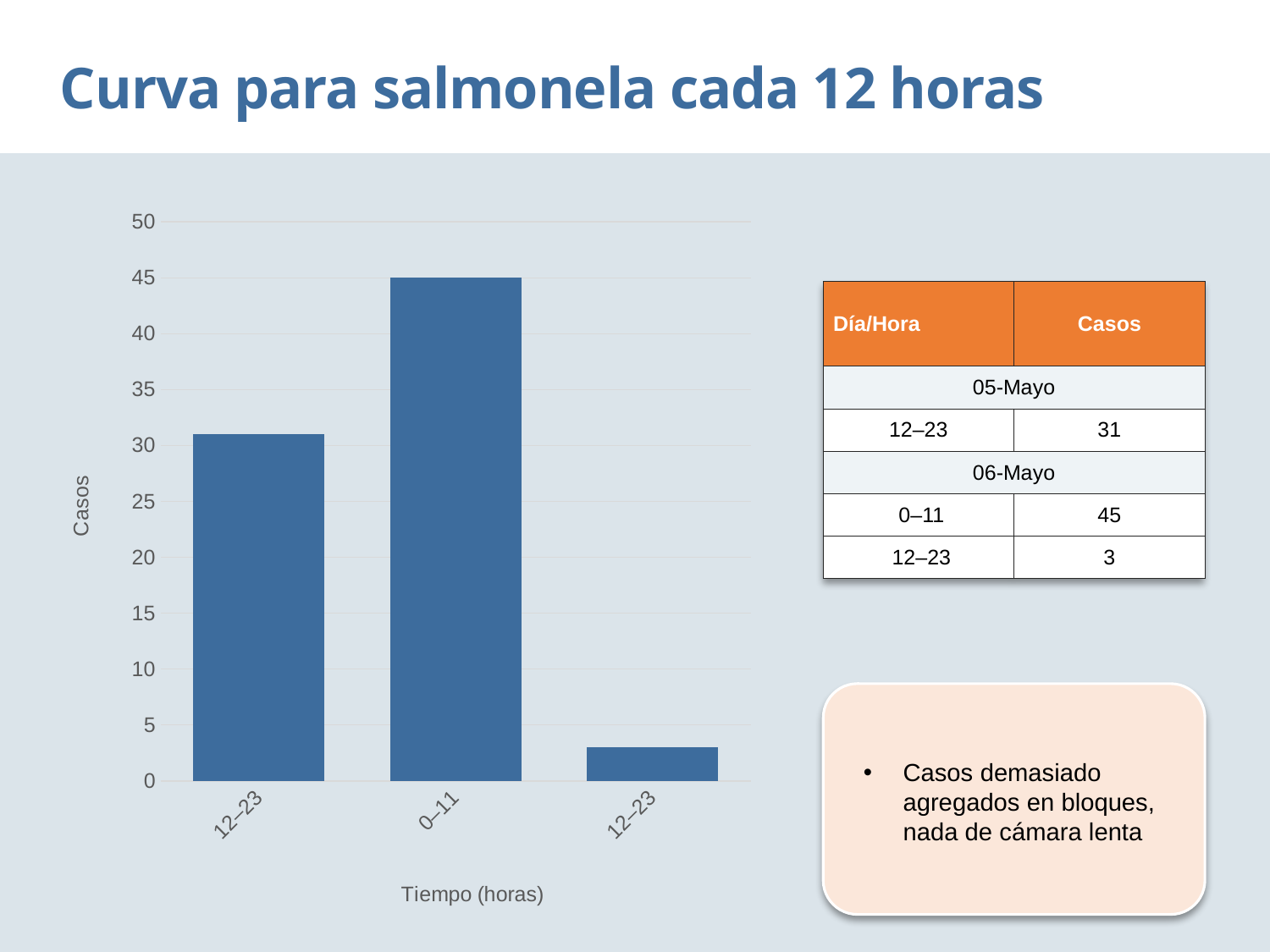
Is the value of the leftmost 12–23 bar greater or less than 30? greater Which bar has the lowest number of cases? the rightmost 12–23 bar What is the label of the y axis? Casos What is the value of the first (leftmost) bar, labelled 12–23? 31 Which is larger, the leftmost 12–23 bar or the rightmost 12–23 bar? the leftmost 12–23 bar What is the label of the x axis? Tiempo (horas) What is the difference in cases between the 0–11 bar and the leftmost 12–23 bar? 14 What type of chart is shown on the slide? bar chart What is the value of the last (rightmost) bar, labelled 12–23? 3 How many bars are plotted in the chart? 3 Which bar has the highest number of cases? 0–11 What is the value of the middle bar, labelled 0–11? 45